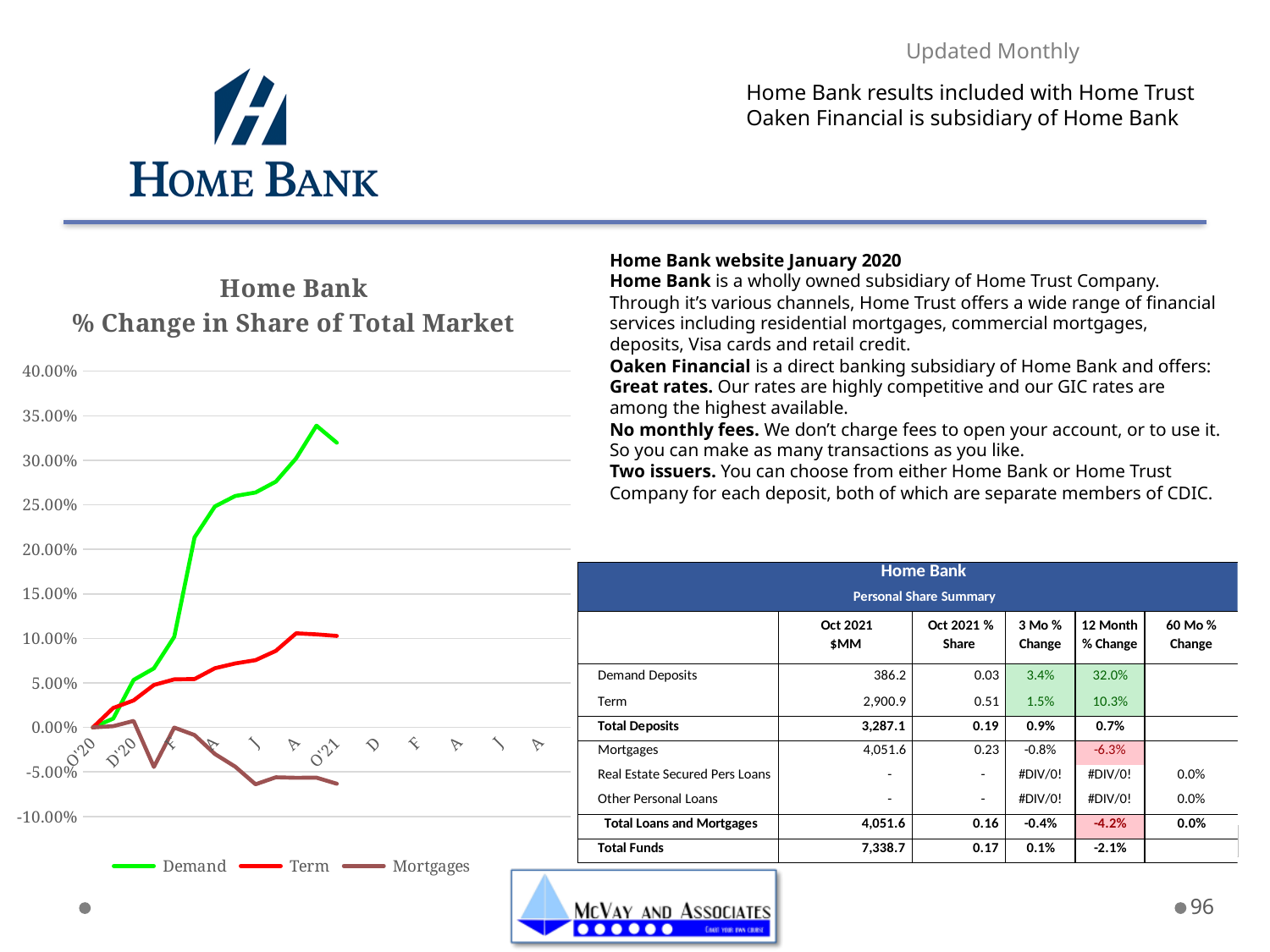
Which series reaches the highest value on the chart? Demand Is the value of the Term series at the right end of the chart greater or less than 15.00%? less Is the peak value of the Demand series greater or less than 30.00%? greater How many series does the legend of the chart list? 3 At the right end of the chart, which series is larger, Demand or Term? Demand Which series in the chart is drawn in green? Demand Is the value of the Mortgages series at the right end of the chart greater or less than 0.00%? less What is the title of the chart on the slide? Home Bank % Change in Share of Total Market Does the Demand series generally rise or fall from O'20 to O'21? rise What kind of chart is shown on the slide? line chart Which series has the lowest values at the right end of the chart? Mortgages Does the Mortgages series generally rise or fall across the chart? fall